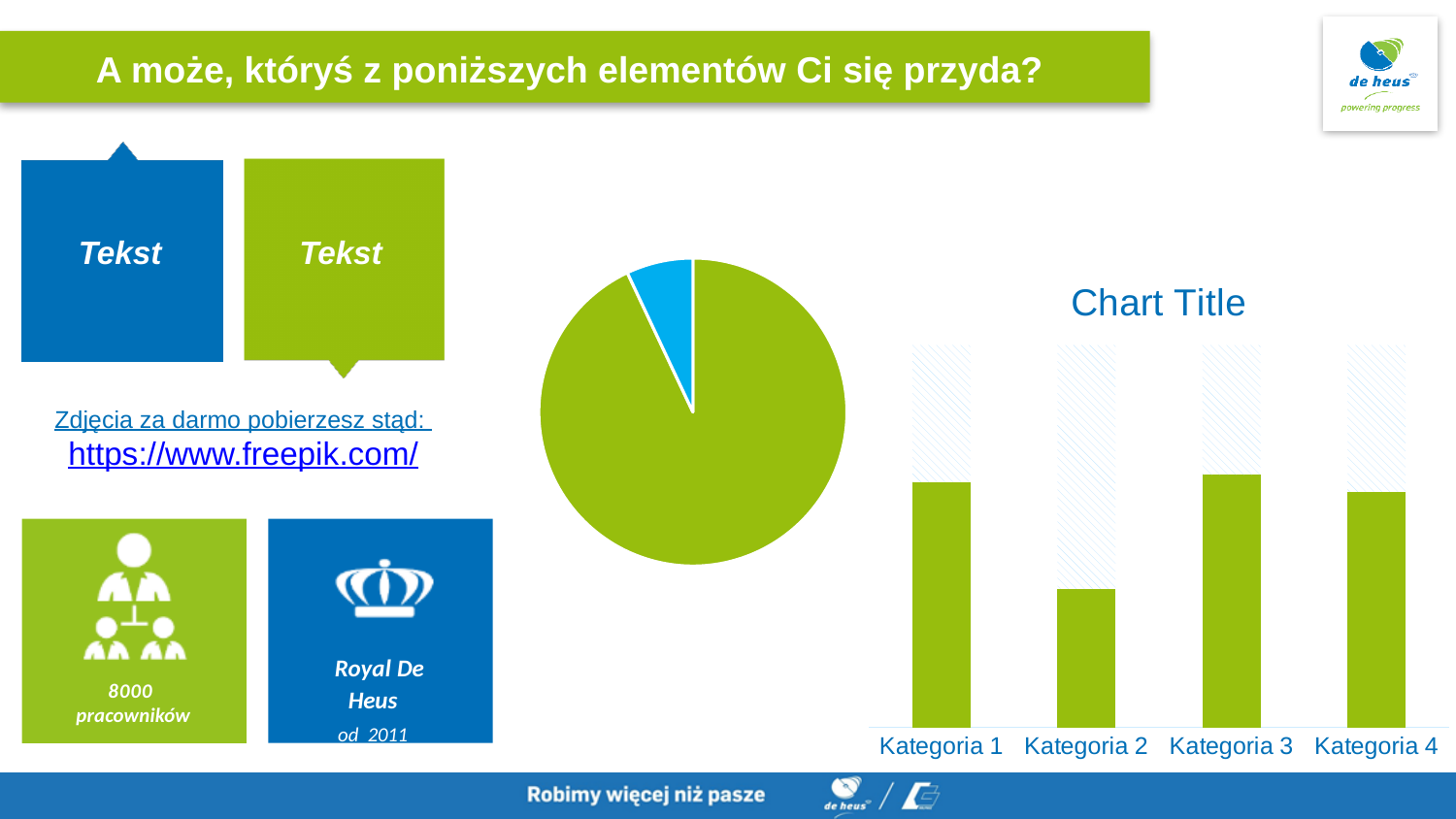
In the bar chart titled "Chart Title", which is larger, the value for Kategoria 3 or Kategoria 4? Kategoria 3 In the bar chart titled "Chart Title", how many categories are shown on the x axis? 4 What kind of chart is the chart on the right titled "Chart Title"? bar chart In the bar chart titled "Chart Title", which is larger, the value for Kategoria 2 or Kategoria 4? Kategoria 4 In the pie chart in the middle of the slide, which slice is larger, the green one or the blue one? the green one What is the title of the bar chart on the right of the slide? Chart Title In the bar chart titled "Chart Title", which category has the highest bar? Kategoria 3 What colour are the bars in the bar chart titled "Chart Title"? green In the bar chart titled "Chart Title", which category has the lowest bar? Kategoria 2 What kind of chart is the chart in the middle of the slide, to the left of "Chart Title"? pie chart In the pie chart in the middle of the slide, how many slices are there? 2